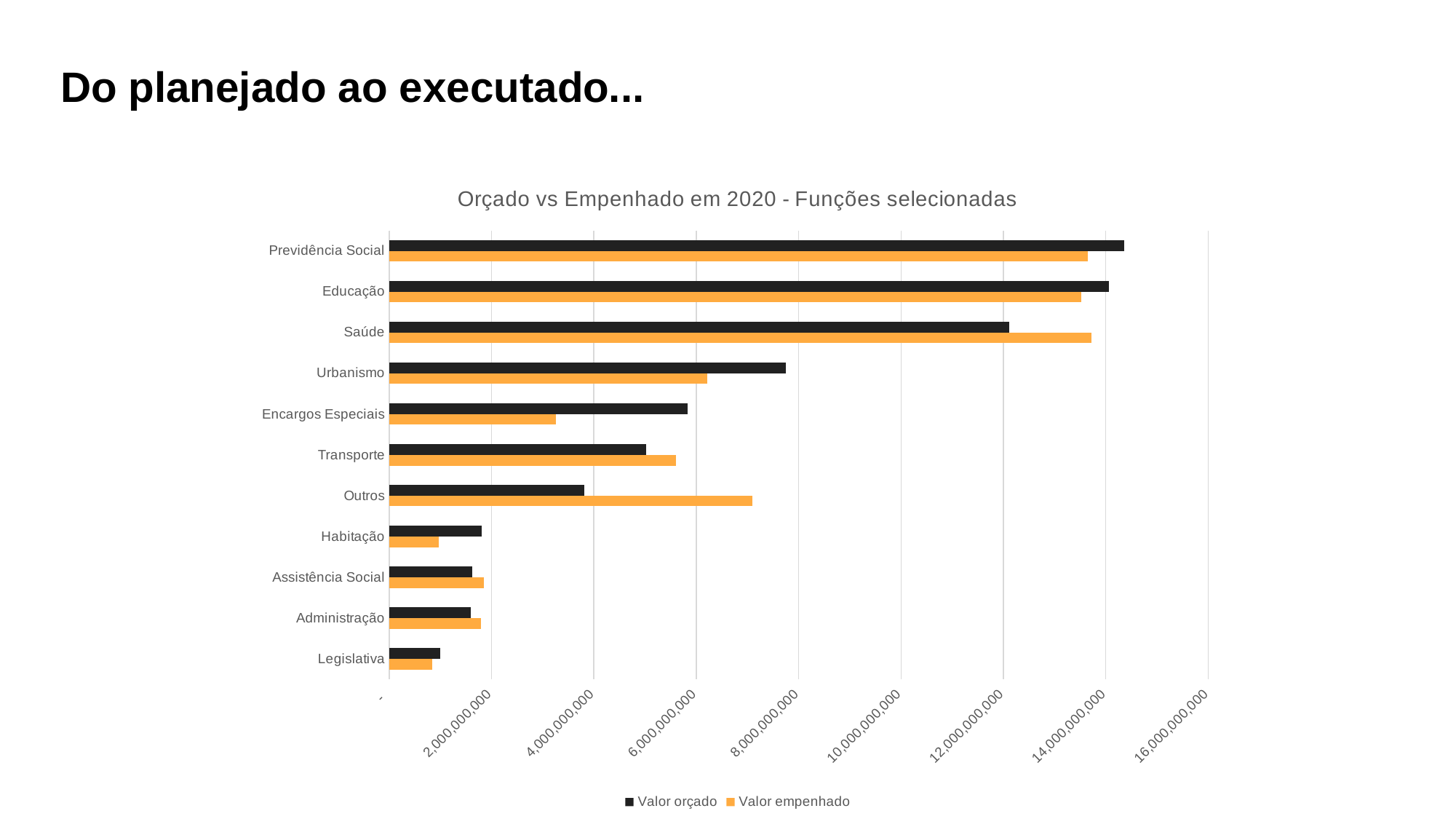
For Saúde, which is larger: Valor orçado or Valor empenhado? Valor empenhado Is the Valor orçado for Urbanismo greater or less than 8,000,000,000? less Is the Valor orçado for Previdência Social greater or less than 14,000,000,000? greater For Encargos Especiais, which is larger: Valor orçado or Valor empenhado? Valor orçado What kind of chart is shown on the slide? Bar chart What is the title of the chart? Orçado vs Empenhado em 2020 - Funções selecionadas Is the Valor empenhado for Encargos Especiais greater or less than 4,000,000,000? less Which colour represents Valor empenhado in the chart? Orange Which category has the lowest Valor orçado? Legislativa How many series does the legend list? 2 How many categories (funções) are shown on the chart? 11